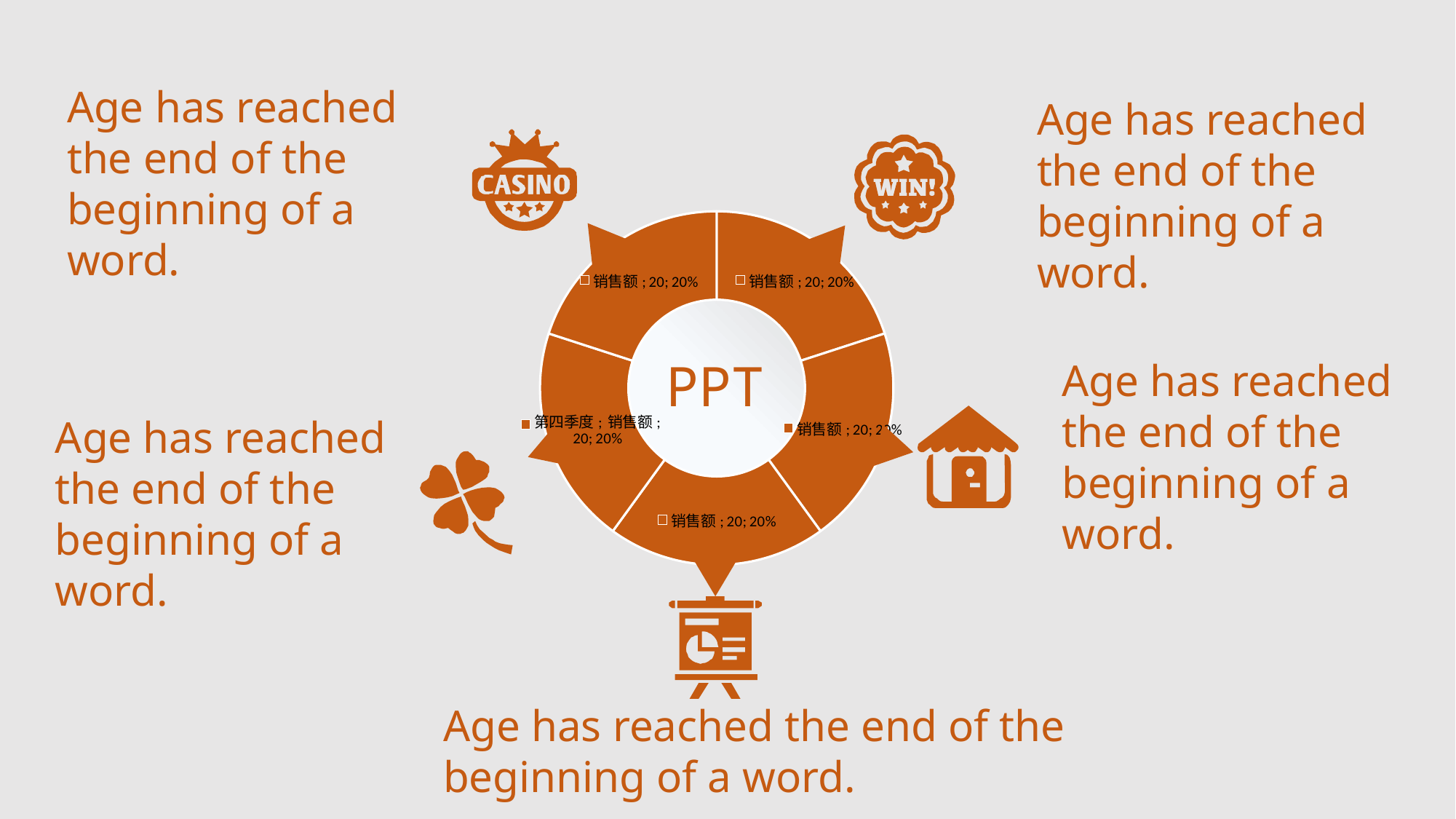
Do all slices of the doughnut chart have the same value? yes What percentage is shown on each slice of the doughnut chart? 20% What share of the doughnut chart does the 第四季度 slice represent? 20% Is the value for the 第四季度 slice greater or less than 10? greater What kind of chart is shown on the slide? doughnut chart What text is displayed in the centre of the doughnut chart? PPT How many slices does the doughnut chart have? 5 What is the value shown for the 第四季度 slice? 20 What is the total of all the slice values in the doughnut chart? 100 What series name appears in the data labels of the doughnut chart? 销售额